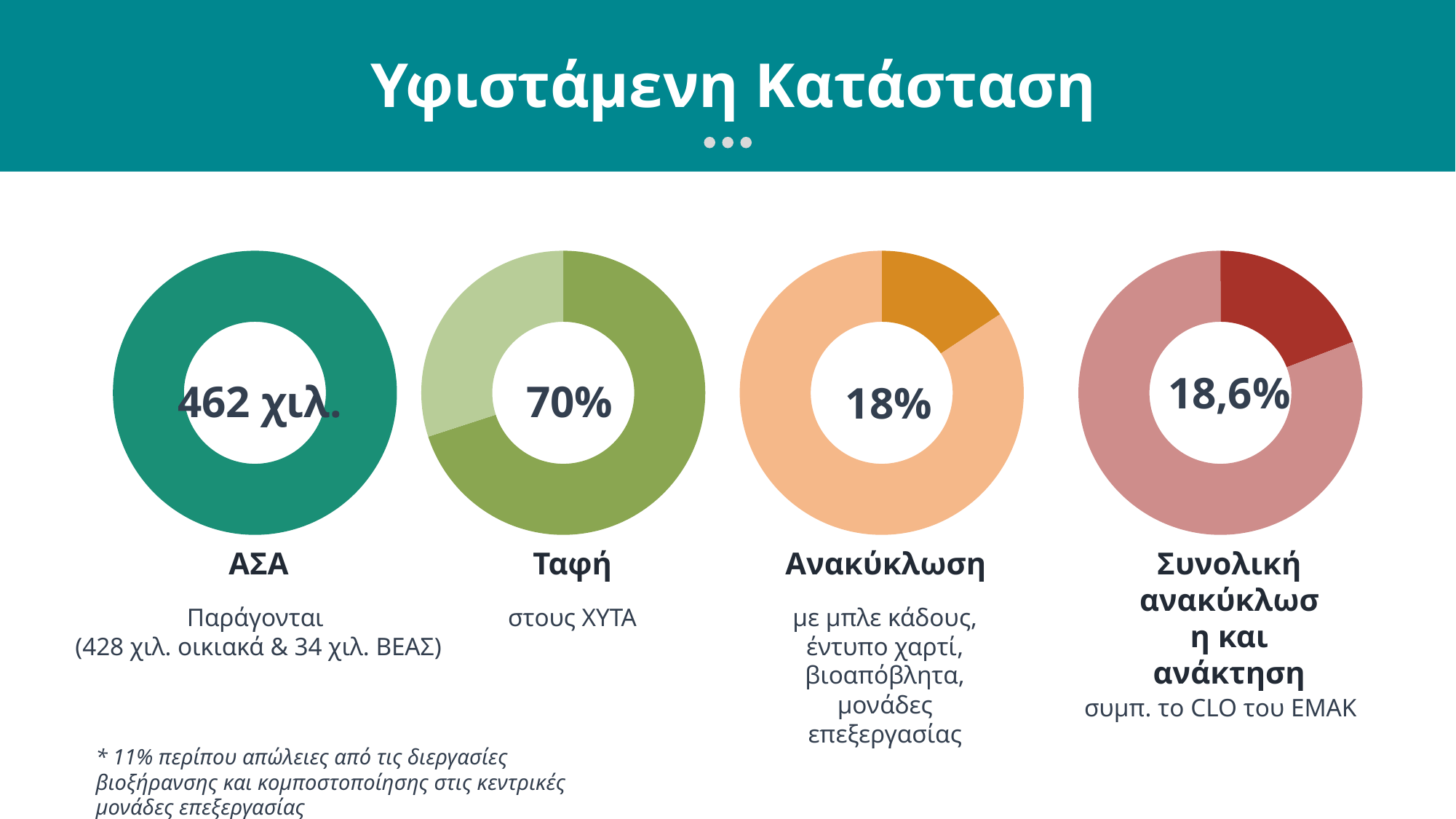
Which of the three percentage donut charts shows the lowest value? Ανακύκλωση What value is shown in the centre of the ΑΣΑ donut chart? 462 χιλ. What kind of charts are shown on the slide? Donut (pie) charts What percentage is shown in the centre of the Ταφή donut chart? 70% How many donut charts are on the slide? 4 What colour is the filled portion of the Ταφή donut chart? Green Which is larger, the Ταφή percentage or the Ανακύκλωση percentage? Ταφή What percentage is shown in the centre of the Συνολική ανακύκλωση και ανάκτηση donut chart? 18,6% Which of the three percentage donut charts shows the highest value? Ταφή What is the difference between the Ταφή percentage and the Ανακύκλωση percentage? 52% What is the title of the slide containing the donut charts? Υφιστάμενη Κατάσταση What percentage is shown in the centre of the Ανακύκλωση donut chart? 18%